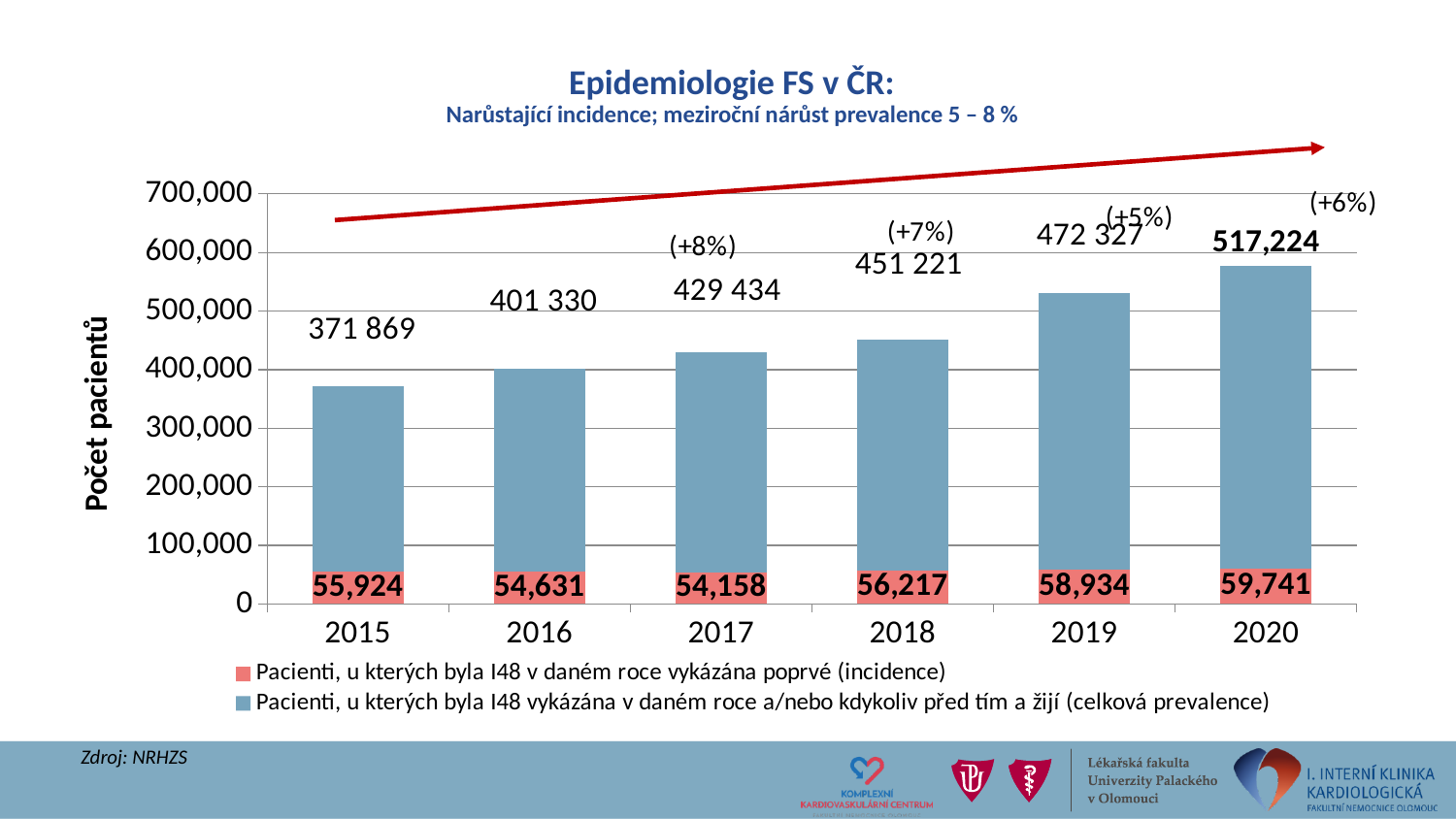
What year-over-year percentage increase is annotated above the 2018 bar? (+7%) Which year has the lowest incidence value? 2017 What kind of chart is shown on the slide? Stacked bar chart What is the incidence value (patients with I48 reported for the first time) shown for 2015? 55,924 How many years are shown on the x axis? 6 How many series does the legend list? 2 Which year has the larger incidence value, 2018 or 2019? 2019 Which year has the highest incidence value? 2020 What is the incidence value shown for 2020? 59,741 What total prevalence value is printed above the bar for 2017? 429 434 What is the difference between the incidence values for 2020 and 2015? 3,817 What total prevalence value is printed above the bar for 2020? 517,224